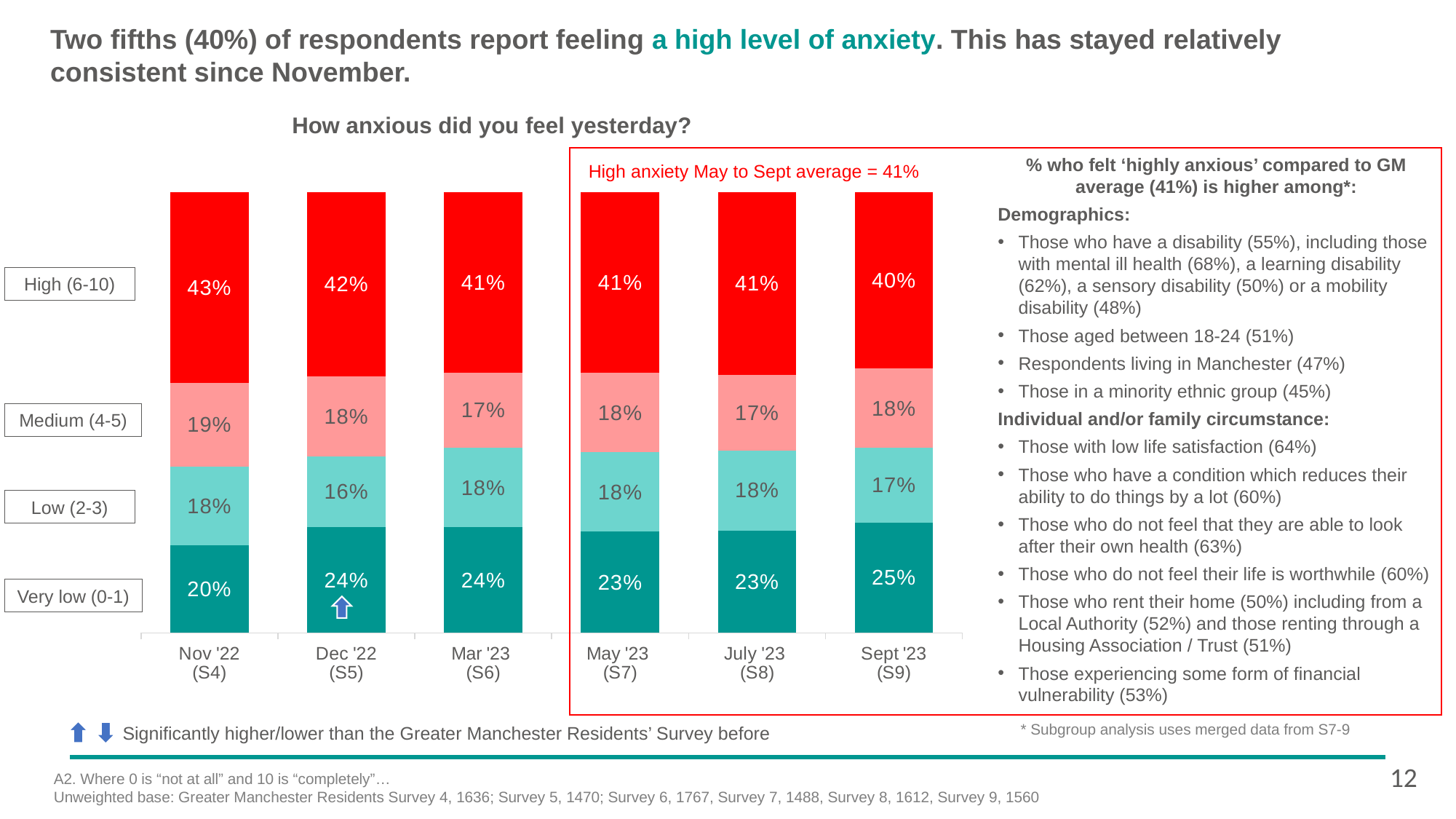
What percentage of respondents reported High (6-10) anxiety in Nov '22 (S4)? 43% In which survey wave was the High (6-10) anxiety share the highest? Nov '22 (S4) In which survey wave was the High (6-10) anxiety share the lowest? Sept '23 (S9) What percentage of respondents reported Low (2-3) anxiety in Dec '22 (S5)? 16% How many anxiety level categories are stacked in each bar? 4 Which wave had a larger Very low (0-1) share, Nov '22 (S4) or Dec '22 (S5)? Dec '22 (S5) By how many percentage points did the High (6-10) share fall from Nov '22 (S4) to Sept '23 (S9)? 3 percentage points How many survey waves are shown on the x axis of the chart? 6 Does the High (6-10) anxiety share rise or fall from Nov '22 to Sept '23? Fall What type of chart is used to show the anxiety levels? Stacked bar chart What percentage of respondents reported Very low (0-1) anxiety in Sept '23 (S9)? 25% What is the total of the four segments in the Nov '22 (S4) bar? 100%